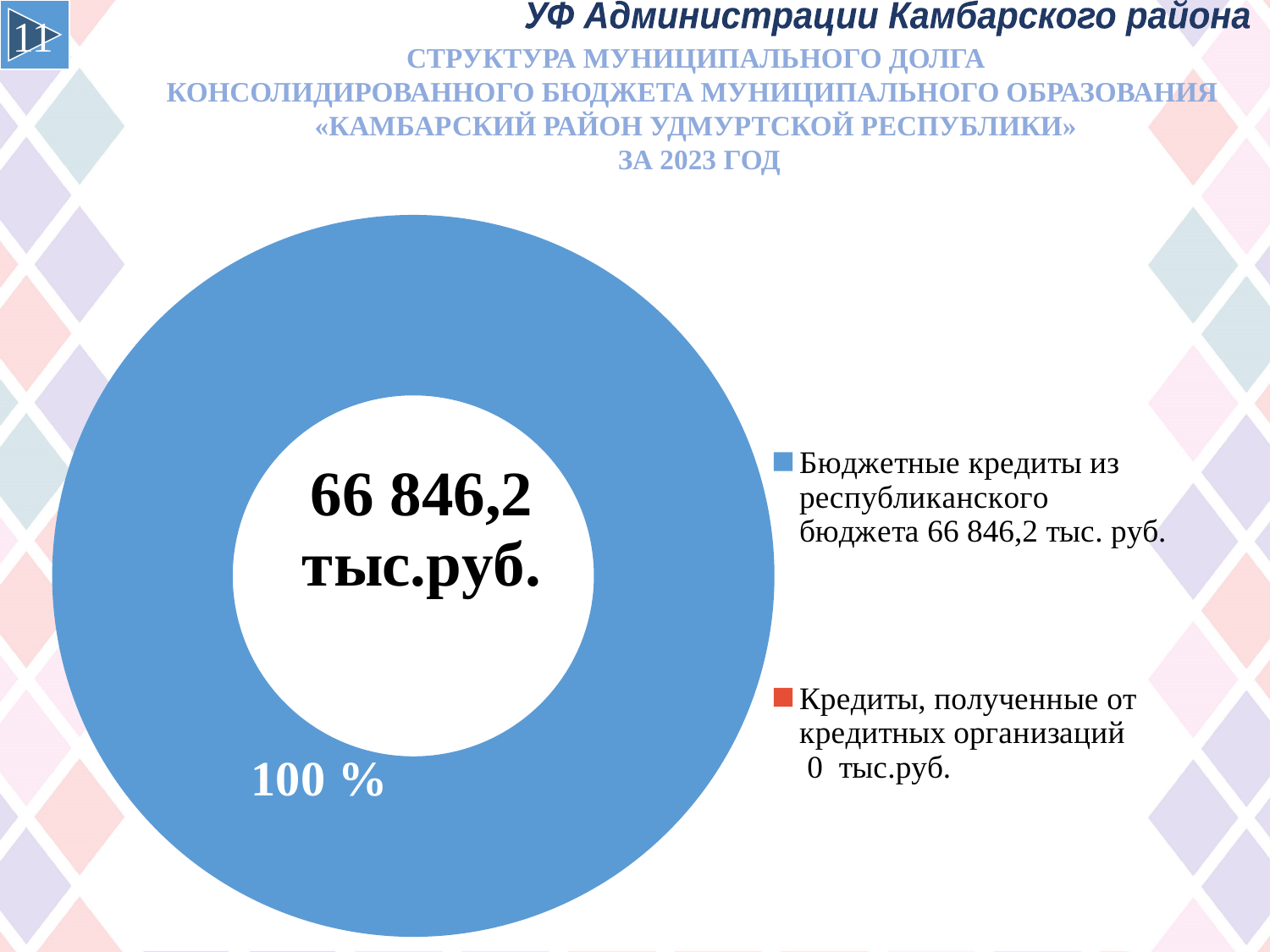
What share of the chart does "Бюджетные кредиты из республиканского бюджета" represent? 100 % What value is shown for "Бюджетные кредиты из республиканского бюджета"? 66 846,2 тыс. руб. What value is shown for "Кредиты, полученные от кредитных организаций"? 0 тыс.руб. Which category has the smallest value? Кредиты, полученные от кредитных организаций What kind of chart is shown on the slide? Donut (pie) chart What percentage label is printed on the chart? 100 % How many entries does the legend list? 2 What is the difference between the value for budget credits from the republican budget and credits from credit organizations? 66 846,2 тыс. руб. Which category makes up the largest share of the chart? Бюджетные кредиты из республиканского бюджета What colour is the legend marker for "Кредиты, полученные от кредитных организаций"? Red (orange-red) Which is larger: budget credits from the republican budget or credits from credit organizations? Бюджетные кредиты из республиканского бюджета What total value is printed in the centre of the donut chart? 66 846,2 тыс.руб.